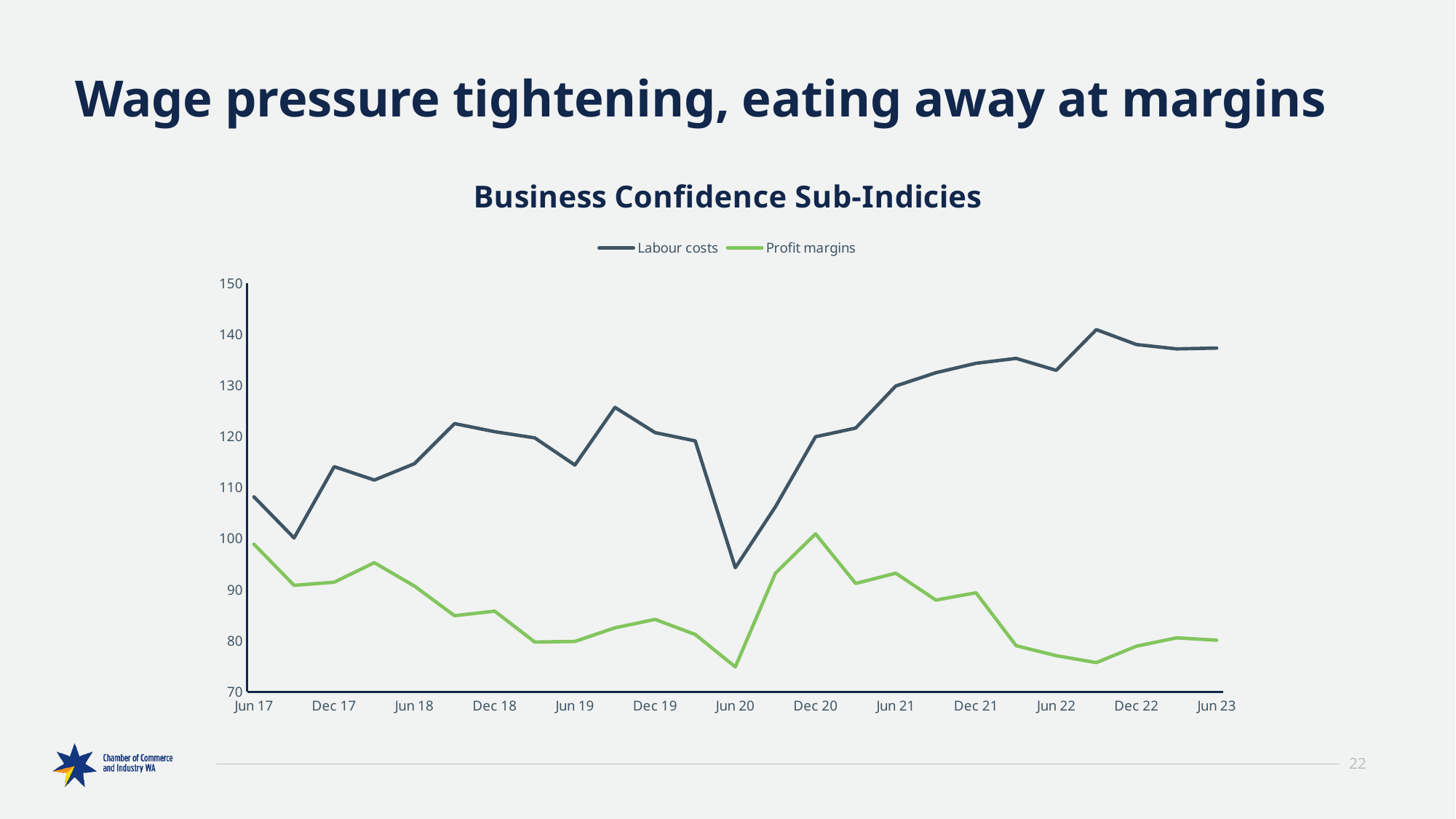
Is the value for Labour costs at Jun 17 greater or less than 100? greater Is the value for Profit margins at Dec 21 greater or less than 100? less What kind of chart is shown on the slide? Line chart At Jun 23, which series has the higher value, Labour costs or Profit margins? Labour costs Is the value for Profit margins at Jun 20 greater or less than 80? less How many series does the legend list? 2 What is the title of the chart? Business Confidence Sub-Indicies At which labelled date is Labour costs at its lowest? Jun 20 Which series is drawn in green? Profit margins Does the Labour costs series overall rise or fall from Jun 17 to Jun 23? Rise